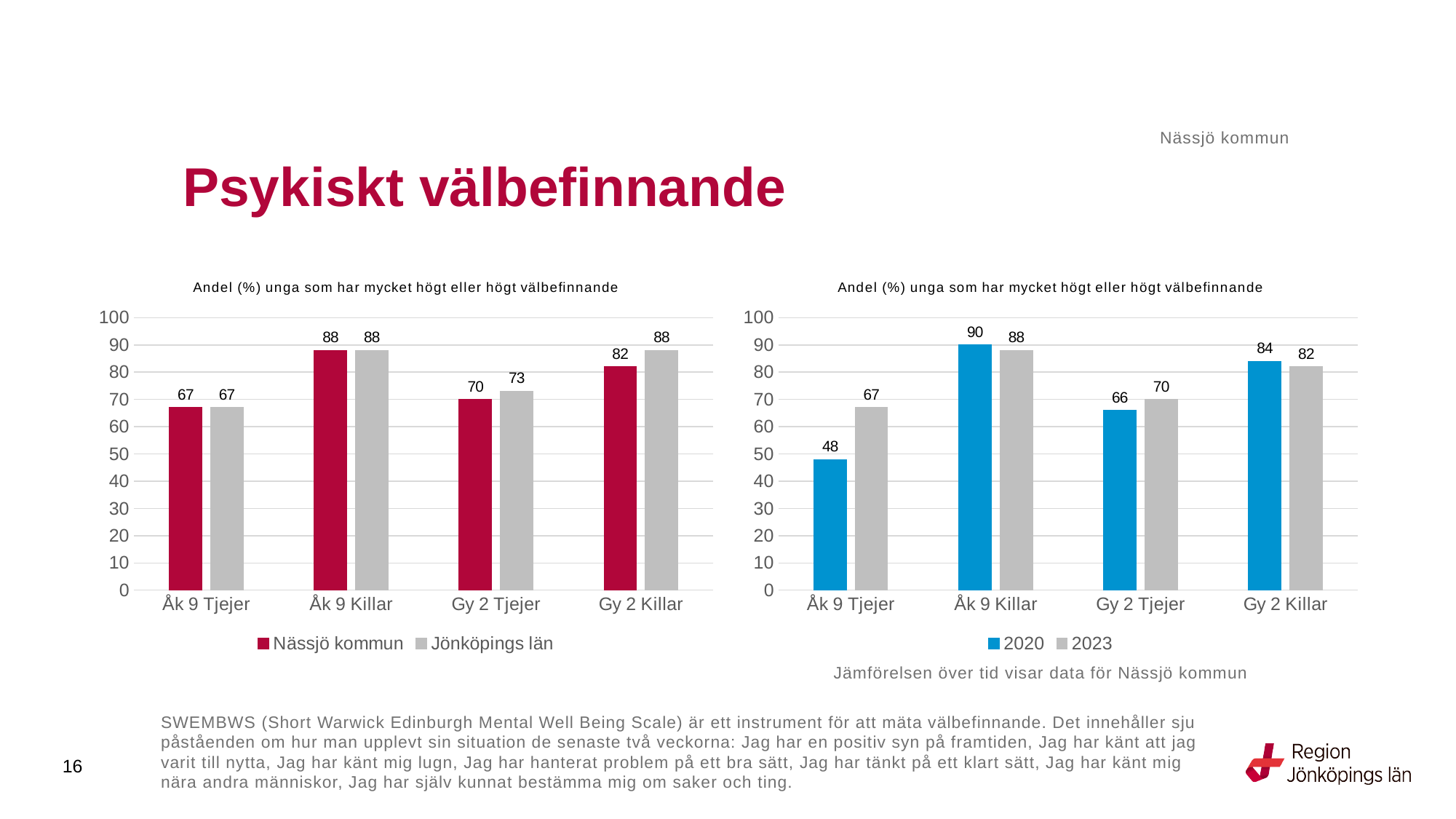
In the right chart, what is the 2023 value for Gy 2 Killar? 82 How many series does the legend of the right chart list? 2 In the left chart, what is the value for Jönköpings län for Gy 2 Tjejer? 73 In the left chart, which category has the highest Nässjö kommun value? Åk 9 Killar In the right chart, what is the difference between the 2023 and 2020 values for Åk 9 Tjejer? 19 In the right chart, which is larger for Gy 2 Killar: the 2020 value or the 2023 value? 2020 What type of chart is the left chart? Bar chart In the left chart, what is the value for Nässjö kommun for Åk 9 Killar? 88 How many categories are shown on the x axis of the left chart? 4 In the right chart, what is the 2020 value for Åk 9 Tjejer? 48 In the left chart, what is the difference between Jönköpings län and Nässjö kommun for Gy 2 Killar? 6 In the right chart, which category has the lowest 2020 value? Åk 9 Tjejer